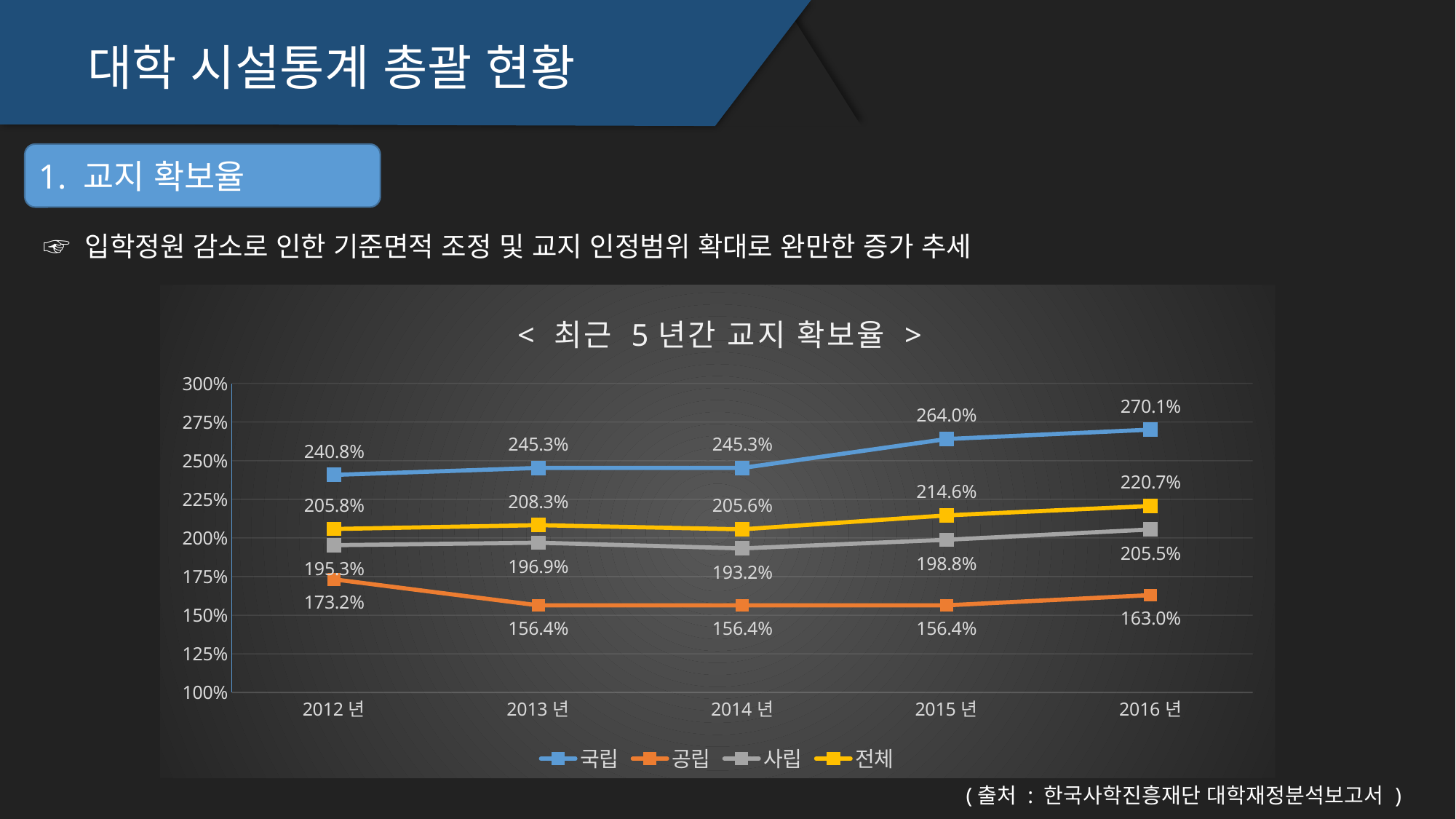
In which year is the 사립 value lowest? 2014 년 What is the value for 국립 in 2016 년? 270.1% What is the difference between the 국립 value in 2016 년 and in 2012 년? 29.3% Does the 국립 series rise or fall from 2014 년 to 2016 년? rise How many series does the legend list? 4 How many years are shown on the x axis? 5 What is the value for 사립 in 2014 년? 193.2% What is the value for 공립 in 2012 년? 173.2% What is the value for 전체 in 2015 년? 214.6% What type of chart is shown on the slide? line chart In which year is the 국립 value highest? 2016 년 Which is larger in 2013 년, the 전체 value or the 사립 value? 전체